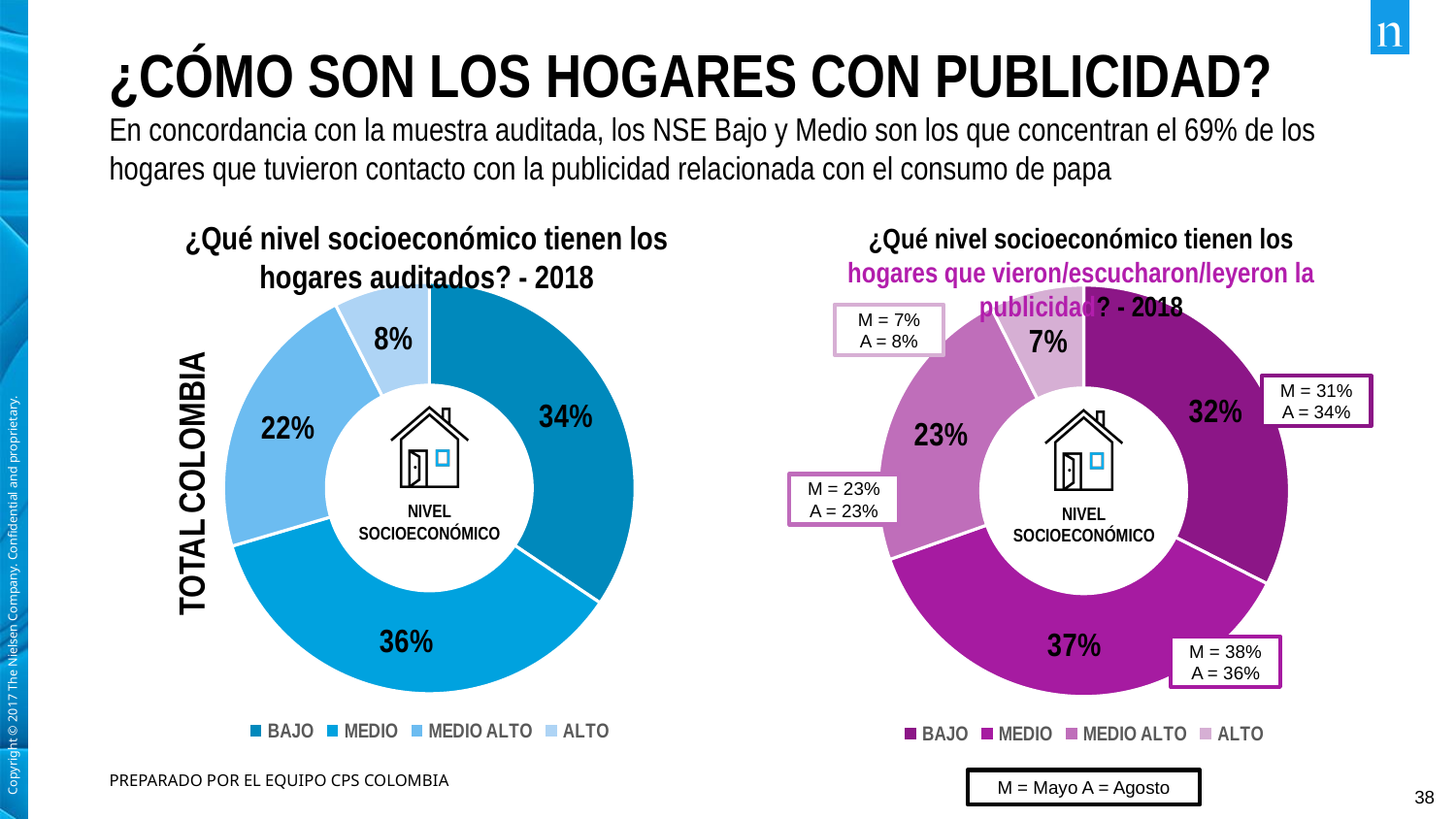
According to the callout on the right chart, what was the BAJO value in Mayo (M)? 31% In the left chart (hogares auditados), what is the difference in percentage points between the MEDIO and MEDIO ALTO segments? 14 In the left chart (hogares auditados), what percentage is shown for the ALTO segment? 8% In the right chart (hogares que vieron/escucharon/leyeron la publicidad), which is larger, the BAJO segment or the MEDIO ALTO segment? BAJO In the right chart (hogares que vieron/escucharon/leyeron la publicidad), which socioeconomic level has the smallest share? ALTO In the right chart (hogares que vieron/escucharon/leyeron la publicidad), what percentage is shown for the MEDIO segment? 37% What type of chart is used on the right side of the slide (hogares que vieron/escucharon/leyeron la publicidad)? Donut (pie) chart In the right chart (hogares que vieron/escucharon/leyeron la publicidad), what is the combined share of the BAJO and MEDIO segments? 69% In the left chart (hogares auditados), which socioeconomic level has the largest share? MEDIO How many segments does the left chart (hogares auditados) have? 4 In the left chart (hogares auditados), what percentage is shown for the BAJO segment? 34% In the right chart (hogares que vieron/escucharon/leyeron la publicidad), what percentage is shown for the MEDIO ALTO segment? 23%